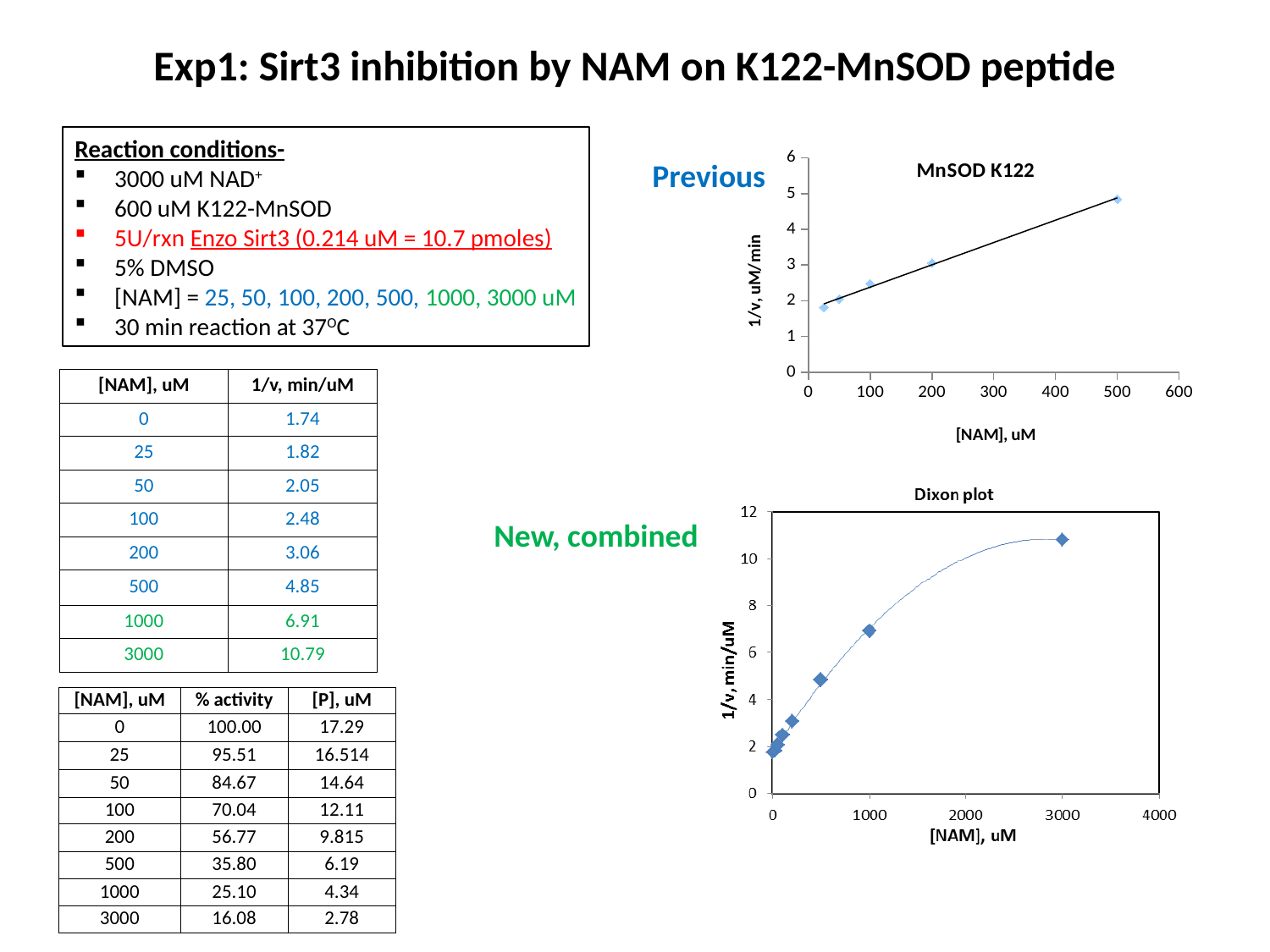
What kind of chart is the Dixon plot? scatter chart In the MnSOD K122 chart, do the values rise or fall as [NAM] increases? rise In the Dixon plot, which [NAM] concentration has the highest 1/v value? 3000 In the Dixon plot, do the values rise or fall as [NAM] increases? rise In the MnSOD K122 chart, is the value at [NAM] = 500 uM greater or less than 4? greater In the MnSOD K122 chart, how many data points are plotted? 5 In the MnSOD K122 chart, is the value at [NAM] = 100 uM greater or less than 3? less In the Dixon plot, is the value at [NAM] = 1000 uM greater or less than 8? less What is the y-axis title of the Dixon plot? 1/v, min/uM What kind of chart is the MnSOD K122 chart on the right of the slide? scatter chart